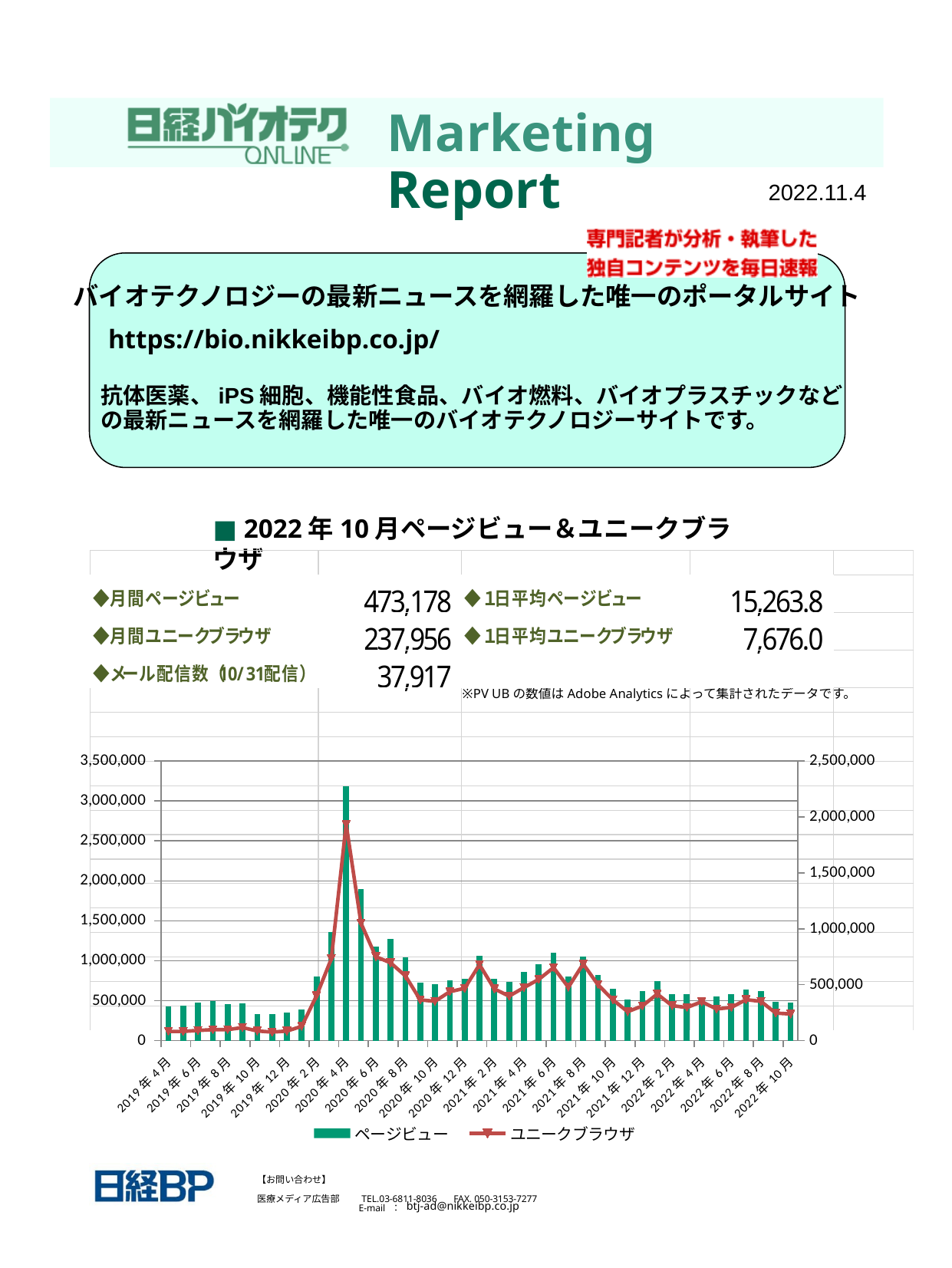
Is the unique browser (ユニークブラウザ) value for 2020年4月 greater or less than 1,500,000 on the right axis? greater What are the two series named in the chart legend? ページビュー and ユニークブラウザ Do the page view (ページビュー) bars rise or fall from 2020年4月 to 2020年10月? fall Is the page view (ページビュー) value for 2020年4月 greater or less than 3,000,000? greater How many series does the chart legend list? 2 Is the unique browser (ユニークブラウザ) value for 2022年10月 greater or less than 500,000 on the right axis? less Which month is the first category on the x axis of the chart? 2019年4月 What is the title of the chart? 2022年10月ページビュー＆ユニークブラウザ In which month do the page views (ページビュー) bars reach their highest value? 2020年4月 Which month has the larger page view (ページビュー) bar, 2020年4月 or 2020年6月? 2020年4月 What kind of chart is shown on the slide? A bar chart combined with a line chart